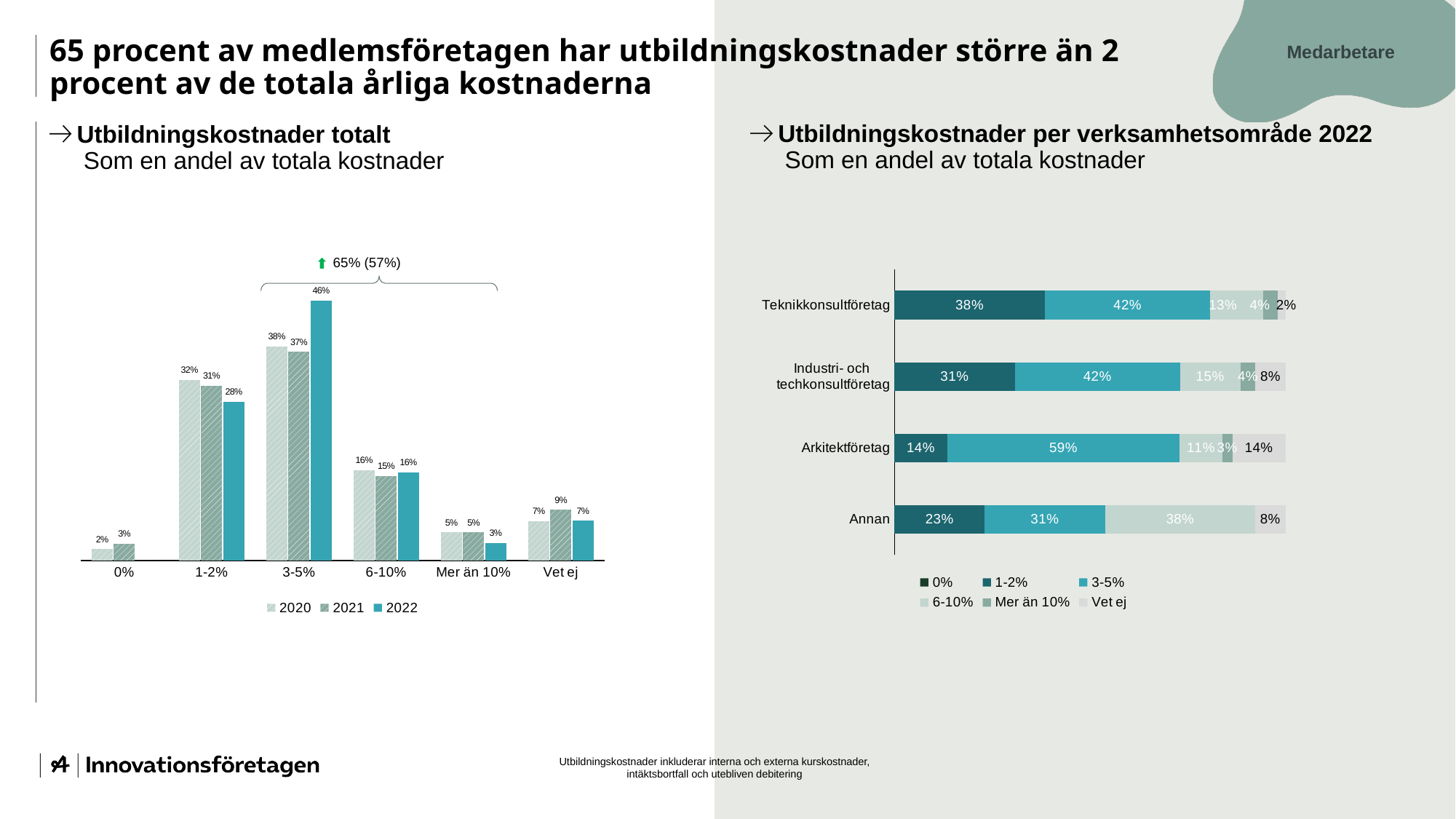
What kind of chart is the right chart 'Utbildningskostnader per verksamhetsområde 2022'? Stacked bar chart In the left chart 'Utbildningskostnader totalt', which is larger in the 1-2% category: the 2020 value or the 2022 value? 2020 In the left chart 'Utbildningskostnader totalt', which category has the highest value for 2022? 3-5% In the right chart 'Utbildningskostnader per verksamhetsområde 2022', how many series does the legend list? 6 In the right chart 'Utbildningskostnader per verksamhetsområde 2022', what is the value of the Vet ej segment for Arkitektföretag? 14% In the left chart 'Utbildningskostnader totalt', how many categories are shown on the x axis? 6 In the left chart 'Utbildningskostnader totalt', what is the value for 2022 in the 3-5% category? 46% In the left chart 'Utbildningskostnader totalt', what is the value for 2020 in the 1-2% category? 32% In the left chart 'Utbildningskostnader totalt', what is the difference between the 2022 and 2021 values in the 3-5% category? 9% In the left chart 'Utbildningskostnader totalt', what is the value for 2021 in the Vet ej category? 9% In the right chart 'Utbildningskostnader per verksamhetsområde 2022', what is the value of the largest segment in the Arkitektföretag bar? 59% In the left chart 'Utbildningskostnader totalt', how many series does the legend list? 3